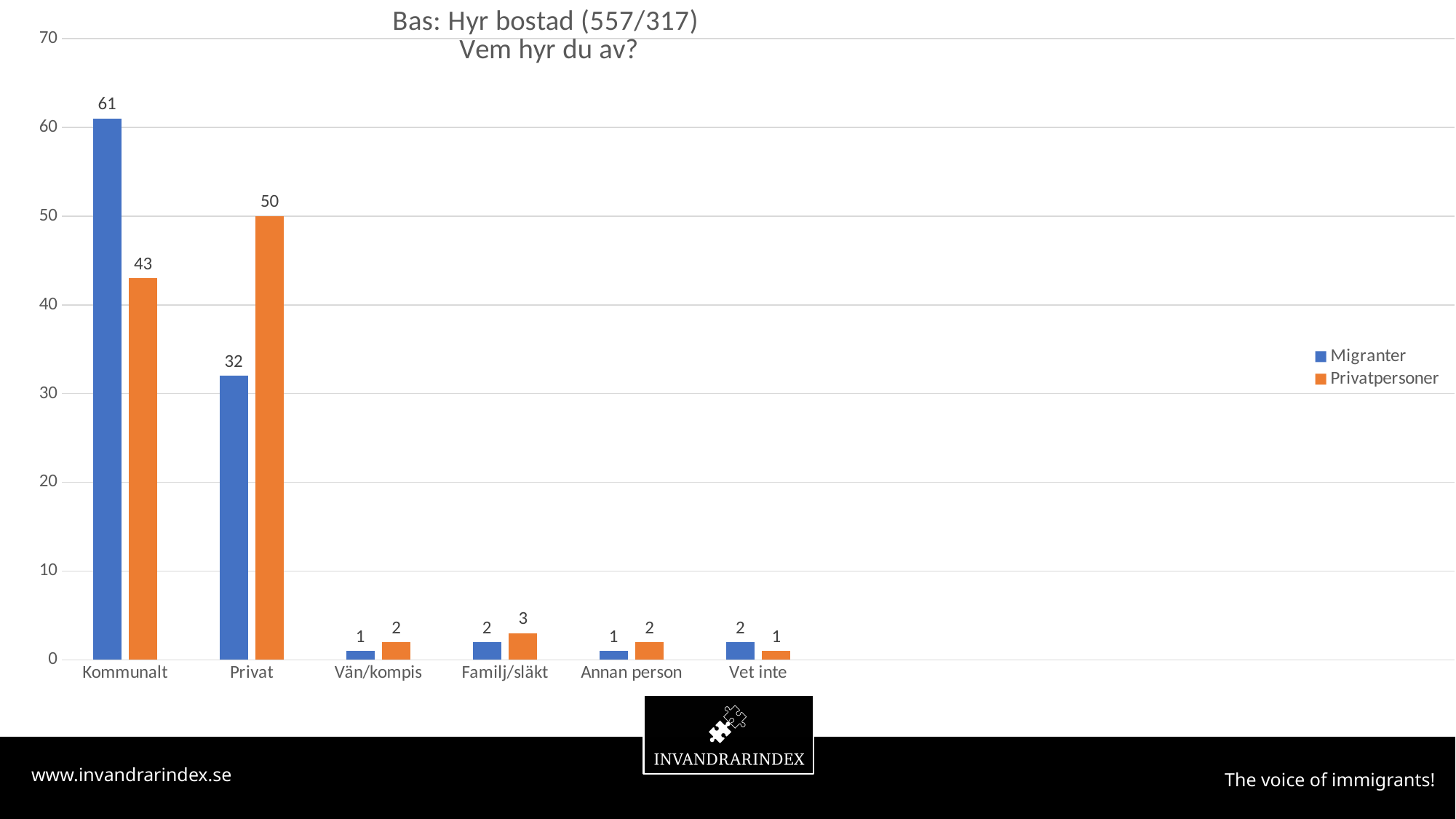
How many series does the legend list? 2 What is the difference between the Privatpersoner and Migranter values for Privat? 18 What is the value for Migranter in the Kommunalt category? 61 How many categories are shown on the x axis? 6 What is the value for Privatpersoner in the Familj/släkt category? 3 Which category has the lowest value for Privatpersoner? Vet inte Which category has the highest value for Migranter? Kommunalt What is the difference between the Migranter and Privatpersoner values for Kommunalt? 18 Is the value for Migranter in Kommunalt greater or less than 60? greater What is the value for Privatpersoner in the Privat category? 50 What kind of chart is shown on the slide? Bar chart Which is larger for Privat: Migranter or Privatpersoner? Privatpersoner